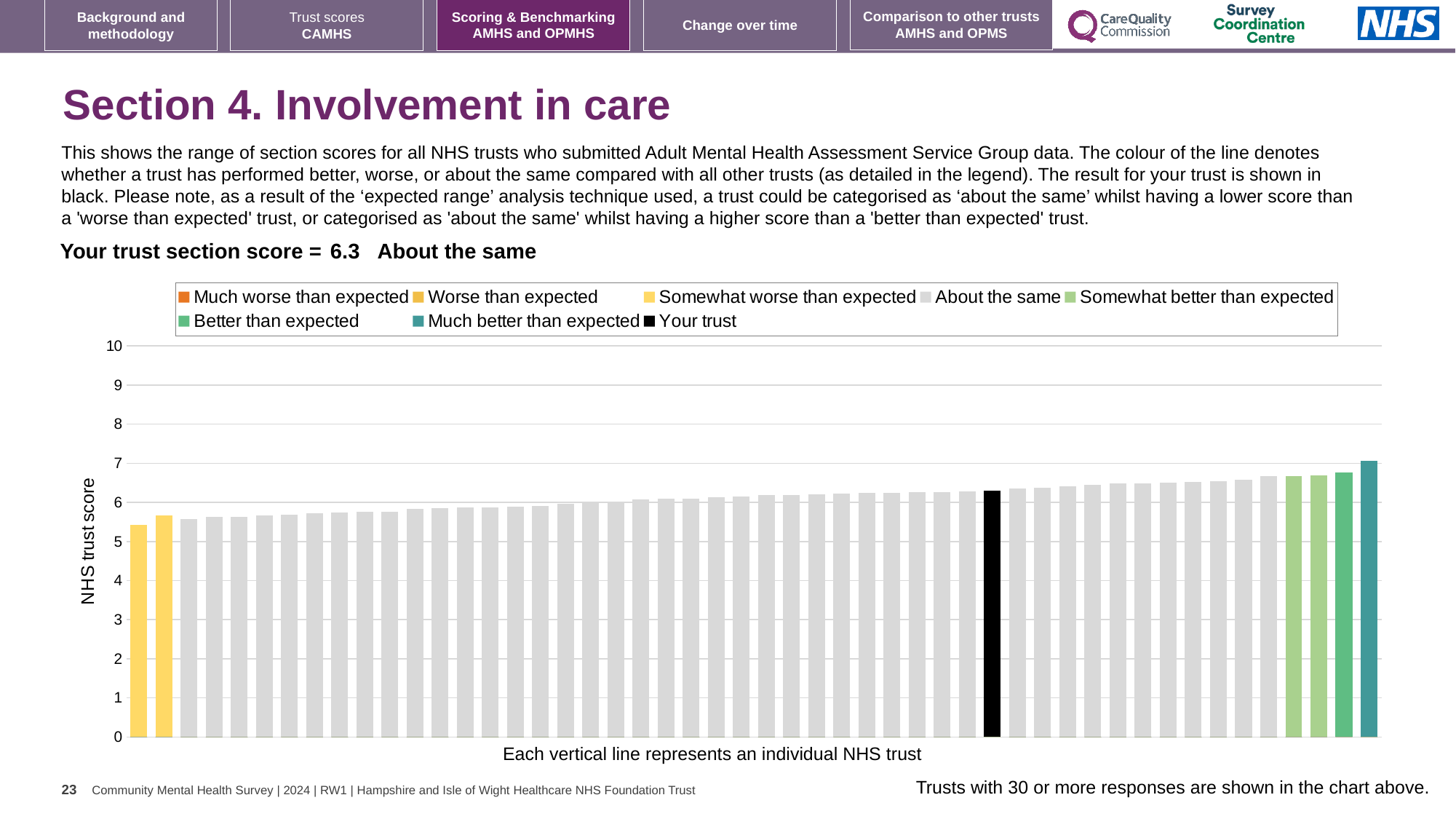
Is the value of the leftmost (lowest) bar greater or less than 5? greater Do the bar values rise or fall moving from left to right along the x axis? rise What kind of chart is shown on the slide? bar chart How many entries does the chart legend list? 8 How many bars are coloured in the 'Much better than expected' teal? 1 Which performance category is your trust placed in for this section? About the same Which is larger, the leftmost bar or the rightmost bar? the rightmost bar Is the value of the leftmost (lowest) bar greater or less than 6? less What is the label on the vertical axis of the chart? NHS trust score Is the value for your trust (the black bar) greater or less than 6? greater What is the section score for your trust shown on the slide? 6.3